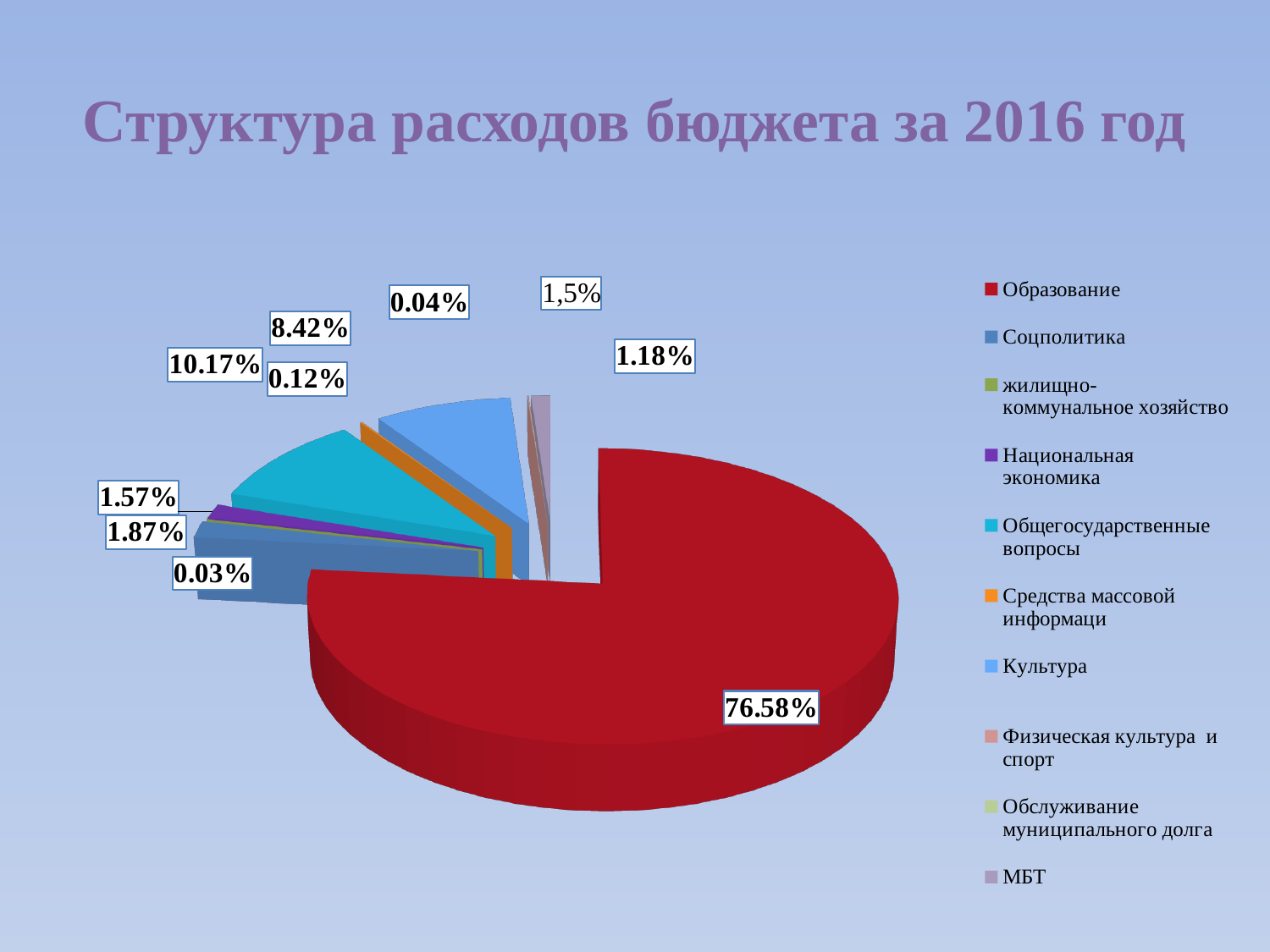
Which category has the largest share of the pie? Образование What is the smallest percentage value labelled on the chart? 0.03% What share of the pie does Образование have? 76.58% How many data labels are shown on the pie chart? 10 Which is larger, the slice for Образование or the slice for Соцполитика? Образование What is the title of the chart? Структура расходов бюджета за 2016 год How many categories does the legend list? 10 What kind of chart is shown on the slide? pie chart What colour is the slice for Образование? red